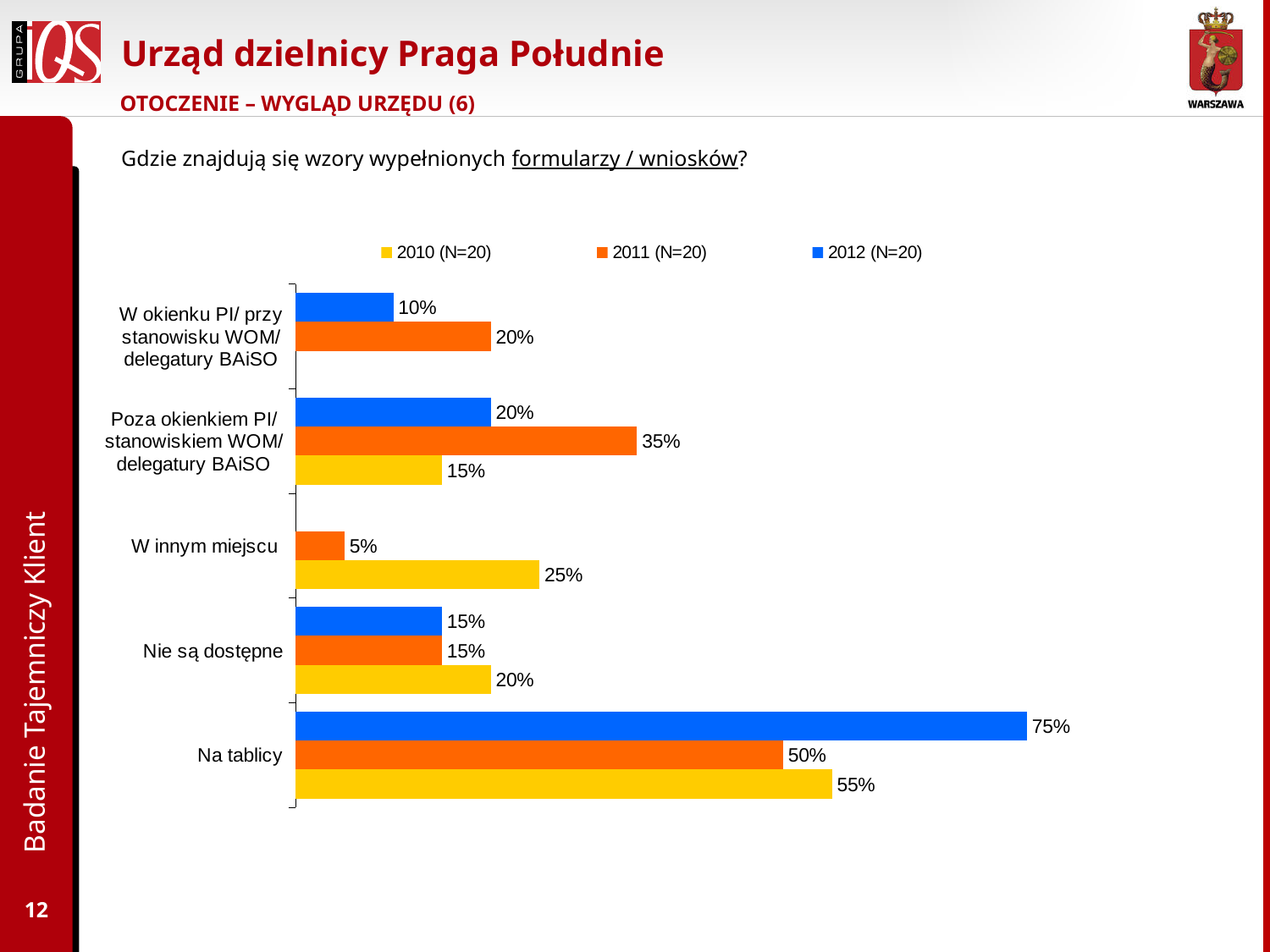
How many categories are shown on the chart? 5 Which is larger for 'Nie są dostępne': the 2010 (N=20) value or the 2011 (N=20) value? 2010 (N=20) How many series does the legend list? 3 Which category has the lowest value in the 2011 (N=20) series? W innym miejscu What is the value for 'Na tablicy' in the 2012 (N=20) series? 75% Which category has the highest value in the 2011 (N=20) series? Na tablicy Which colour represents the 2012 (N=20) series? Blue What is the value for 'W innym miejscu' in the 2010 (N=20) series? 25% What is the value for 'W okienku PI/ przy stanowisku WOM/ delegatury BAiSO' in the 2012 (N=20) series? 10% What is the value for 'Poza okienkiem PI/ stanowiskiem WOM/ delegatury BAiSO' in the 2011 (N=20) series? 35% What is the difference between the 2012 (N=20) and 2010 (N=20) values for 'Na tablicy'? 20% What kind of chart is shown on the slide? Bar chart